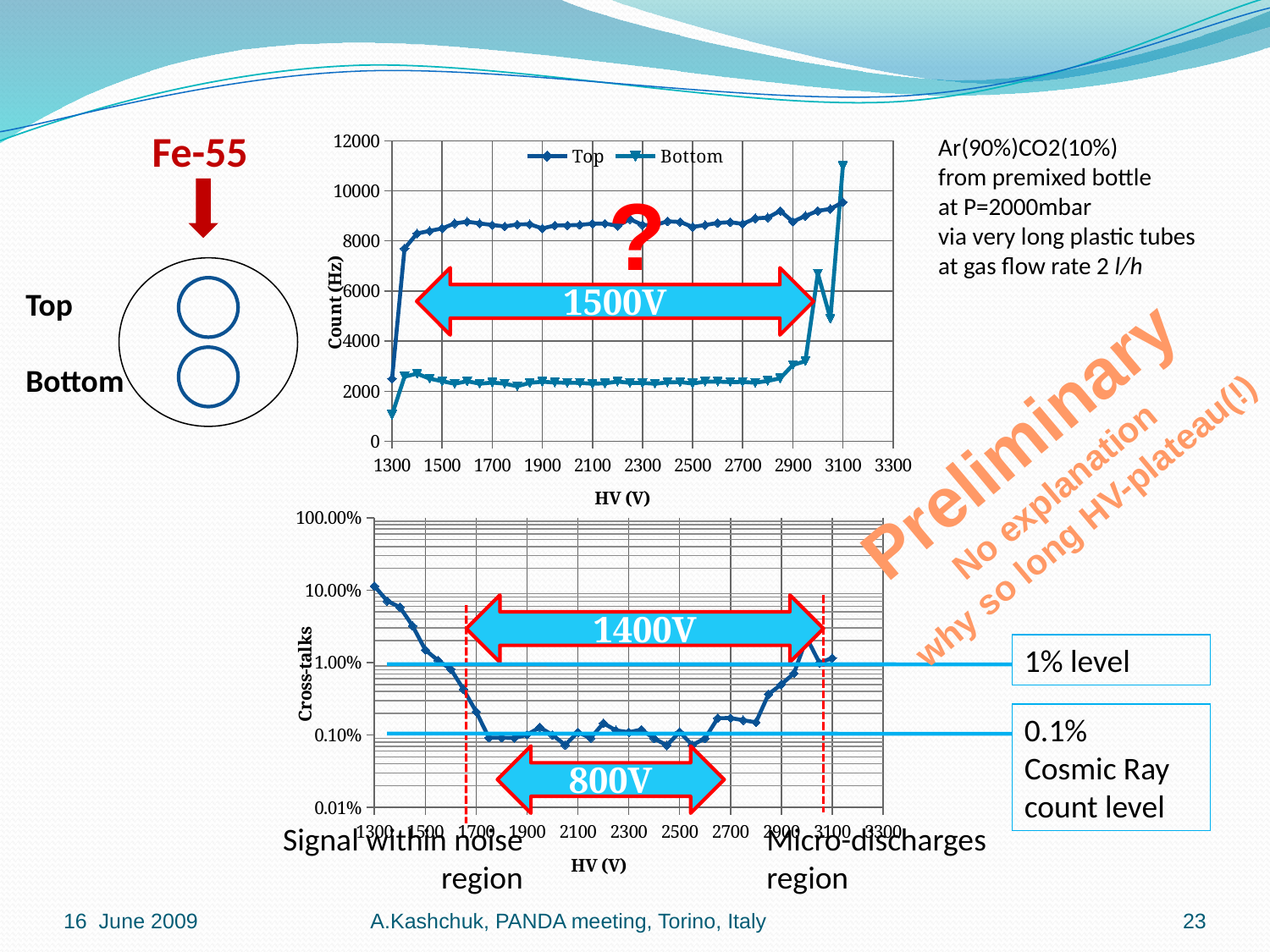
What kind of chart is the lower chart (Cross-talks vs HV (V))? line chart In the upper chart, which series has the higher count at 2500 V, Top or Bottom? Top How many series does the legend of the upper chart list? 2 In the lower chart, is the cross-talk value at 2900 V greater or less than 1.00%? less In the upper chart, is the Top series value at 2100 V greater or less than 8000? greater What are the two series named in the legend of the upper chart? Top and Bottom What is the y-axis title of the upper chart? Count (Hz) In the upper chart, is the Bottom series value at 2100 V greater or less than 4000? less What kind of chart is the upper chart (Count (Hz) vs HV (V))? line chart In the lower chart, do the cross-talk values rise or fall as HV increases from 1300 V to 1900 V? fall